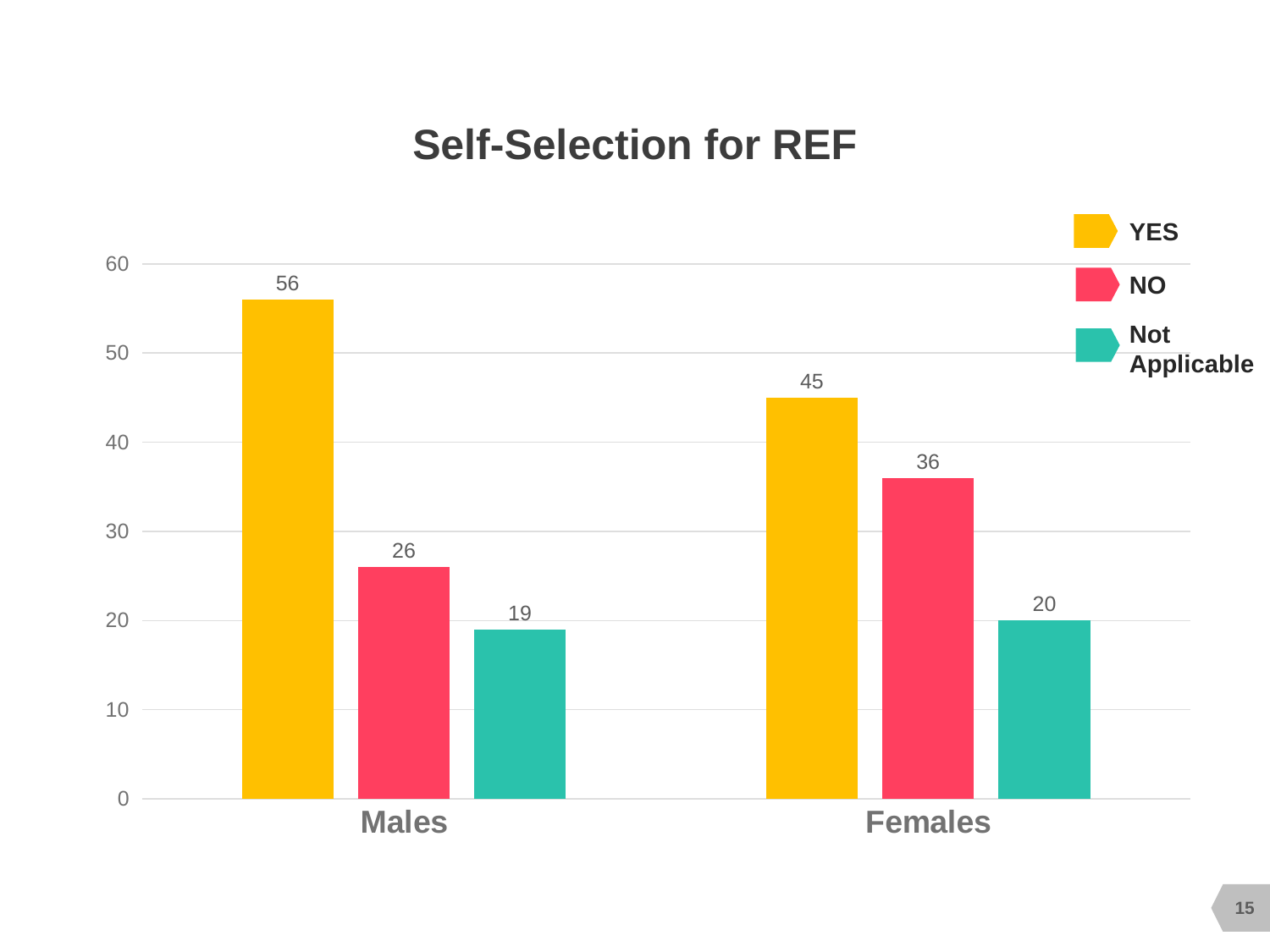
What is the Not Applicable value for Males? 19 How many categories are shown on the x axis? 2 What is the NO value for Females? 36 What is the difference between the YES values for Males and Females? 11 Which series has the highest value for Females? YES What is the title of the chart? Self-Selection for REF Which is larger, the NO value for Males or the NO value for Females? Females What kind of chart is shown? bar chart How many series does the legend list? 3 Which series has the lowest value for Males? Not Applicable What is the YES value for Males? 56 Is the YES value for Females greater or less than 40? greater